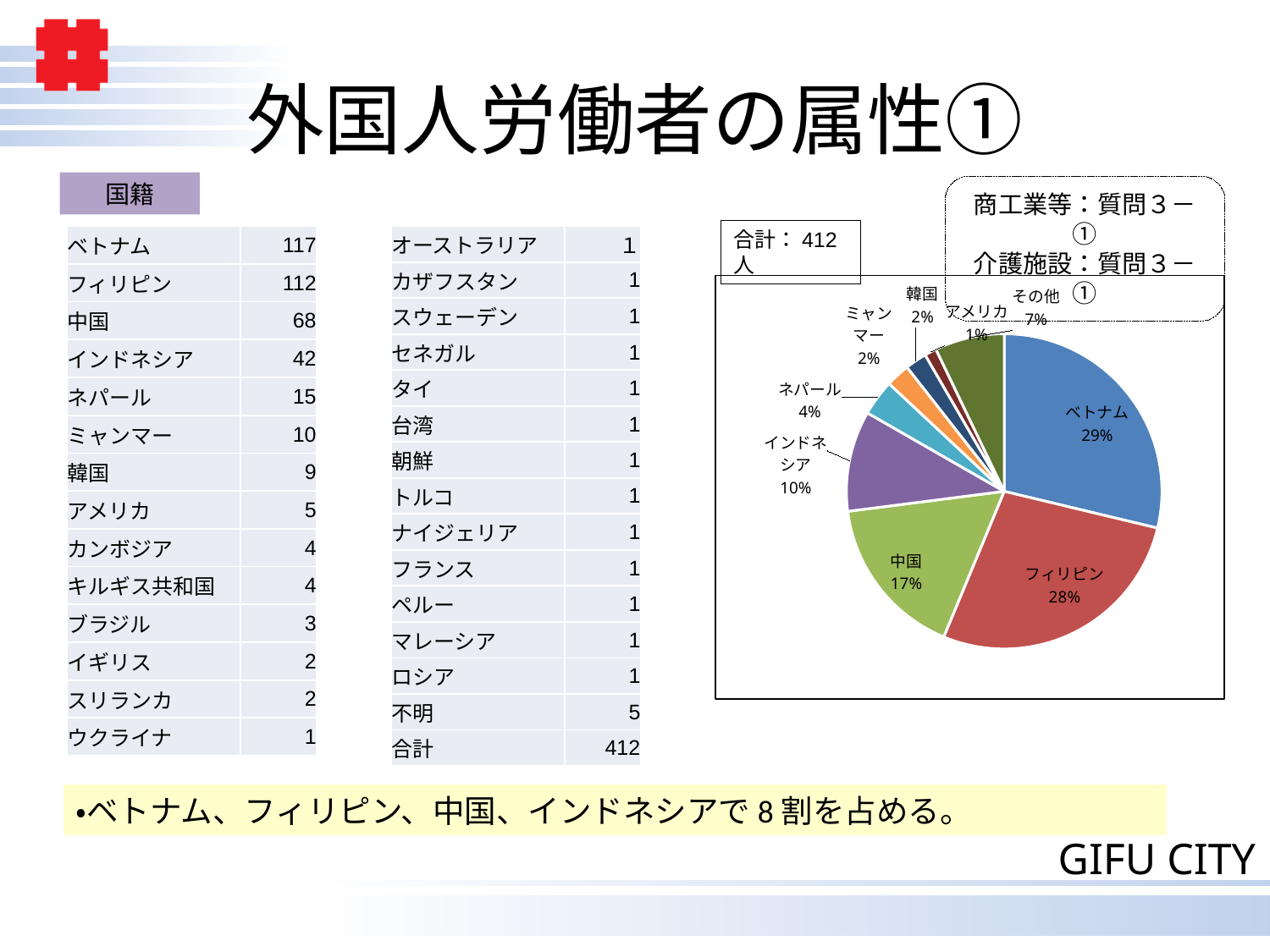
How many slices does the pie chart have? 9 What share of the pie chart does その他 account for? 7% What is the difference in percentage points between the 中国 slice and the インドネシア slice? 7% What total number of people does the box above the pie chart state? 412人 What share of the pie chart does 中国 account for? 17% What share of the pie chart does インドネシア account for? 10% What kind of chart is shown on the slide? pie chart Which slice of the pie chart is the smallest? アメリカ Which slice of the pie chart is the largest? ベトナム